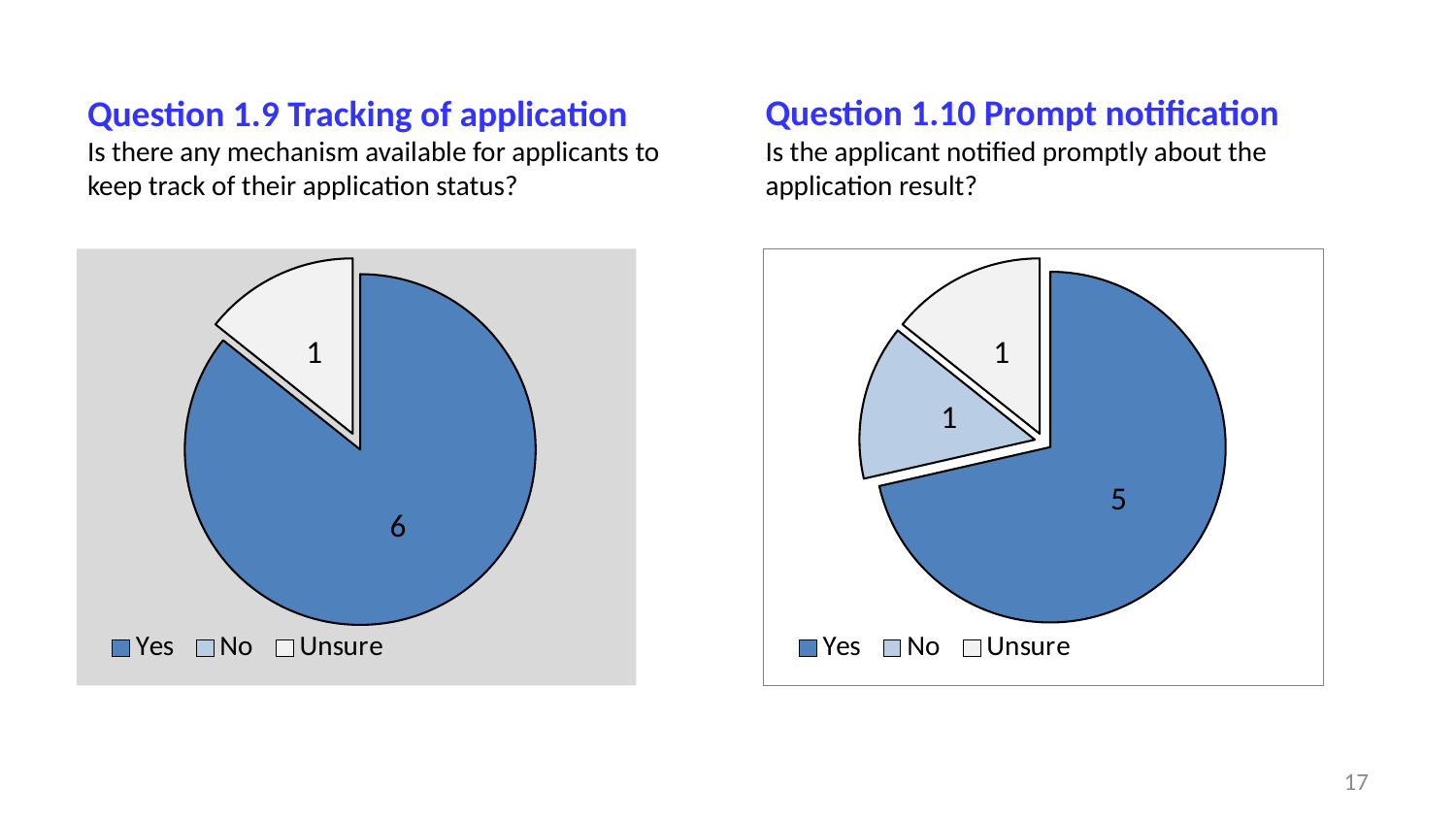
What type of chart is used for Question 1.10 Prompt notification? Pie chart How many entries does the legend of the Question 1.9 Tracking of application chart list? 3 In the Question 1.10 Prompt notification chart, what is the value for No? 1 In the Question 1.10 Prompt notification chart, what is the value for Yes? 5 In the Question 1.9 Tracking of application chart, which category has the largest slice? Yes In the Question 1.9 Tracking of application chart, what is the difference between the Yes value and the Unsure value? 5 In the Question 1.10 Prompt notification chart, which category has the largest slice? Yes In the Question 1.10 Prompt notification chart, what is the total of all the labelled slices? 7 In the Question 1.10 Prompt notification chart, what is the difference between the Yes value and the No value? 4 In the Question 1.9 Tracking of application chart, what is the value for Yes? 6 Is the Yes value larger in the Question 1.9 Tracking of application chart or in the Question 1.10 Prompt notification chart? Question 1.9 Tracking of application In the Question 1.9 Tracking of application chart, what is the value for Unsure? 1